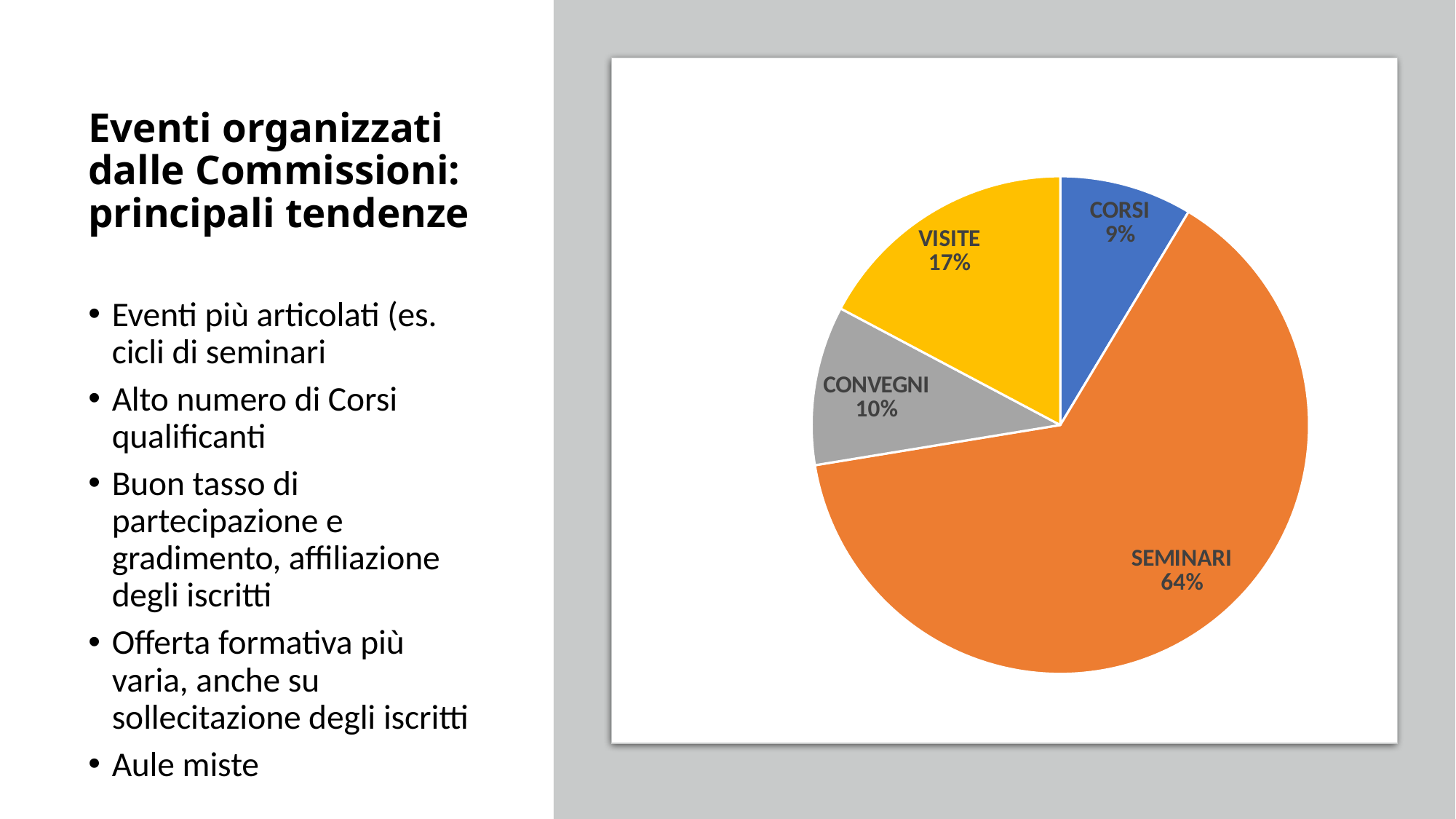
What share of the pie does CORSI represent? 9% What share of the pie does VISITE represent? 17% What kind of chart is shown on the slide? pie chart How many slices does the pie chart have? 4 Which category has the largest slice of the pie? SEMINARI What share of the pie does SEMINARI represent? 64% What colour is the SEMINARI slice? orange What is the combined share of CORSI and CONVEGNI? 19% Which is larger, the share for VISITE or the share for CONVEGNI? VISITE Which category has the smallest slice of the pie? CORSI What is the difference in percentage points between SEMINARI and VISITE? 47